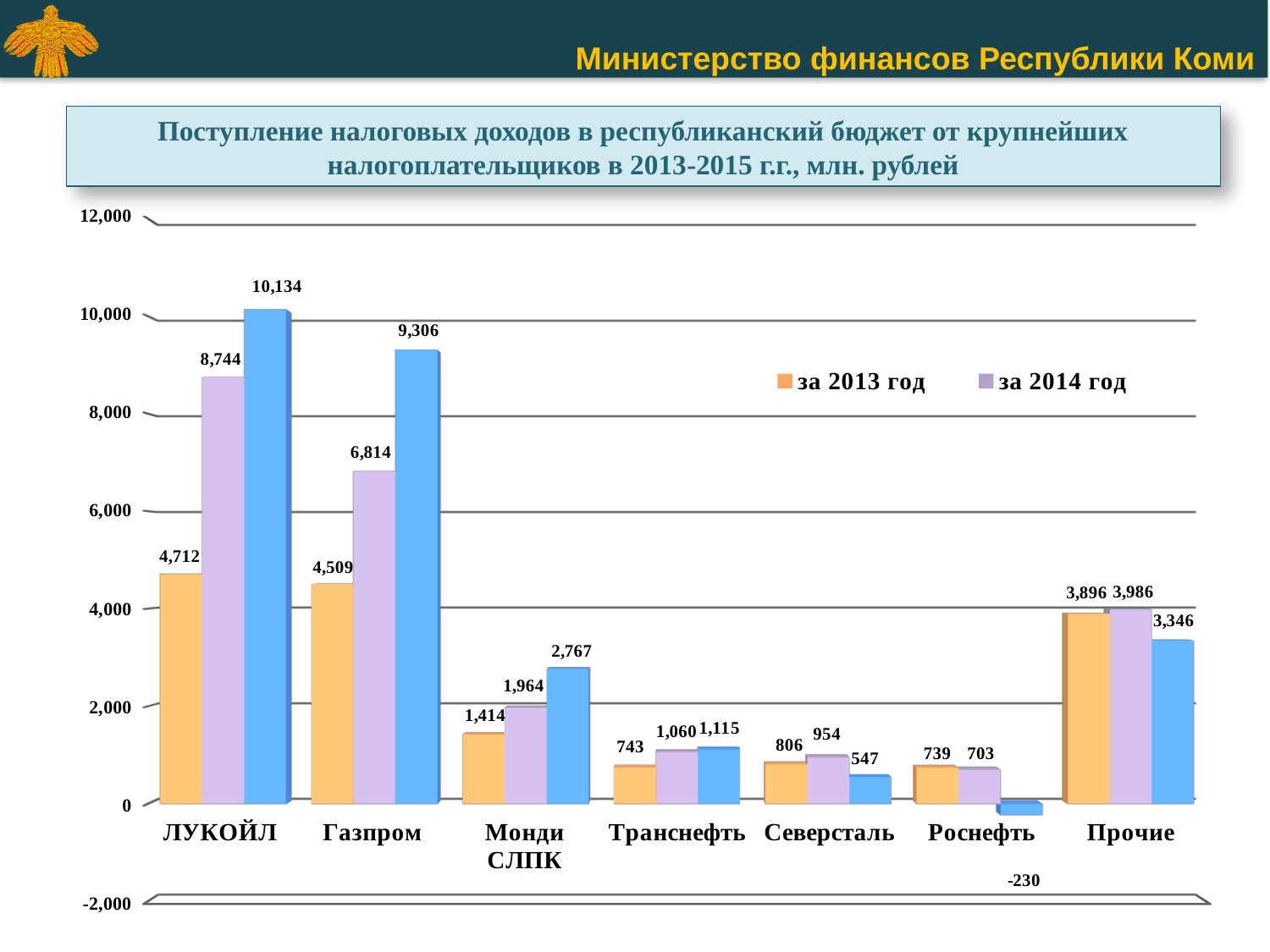
How many series does the legend list? 2 What is the value for Монди СЛПК in the series "за 2014 год"? 1,964 What value is shown by the blue bar for Роснефть? -230 What is the value for ЛУКОЙЛ in the series "за 2013 год"? 4,712 What is the difference between the "за 2014 год" and "за 2013 год" values for Прочие? 90 How many categories are shown on the x axis? 7 Which category has the highest value in the series "за 2014 год"? ЛУКОЙЛ What is the value for Газпром in the series "за 2014 год"? 6,814 Which category has the lowest value in the series "за 2014 год"? Роснефть What is the difference between the "за 2014 год" and "за 2013 год" values for ЛУКОЙЛ? 4,032 For Северсталь, which is larger: the value for "за 2013 год" or "за 2014 год"? за 2014 год What kind of chart is shown on the slide? Bar chart